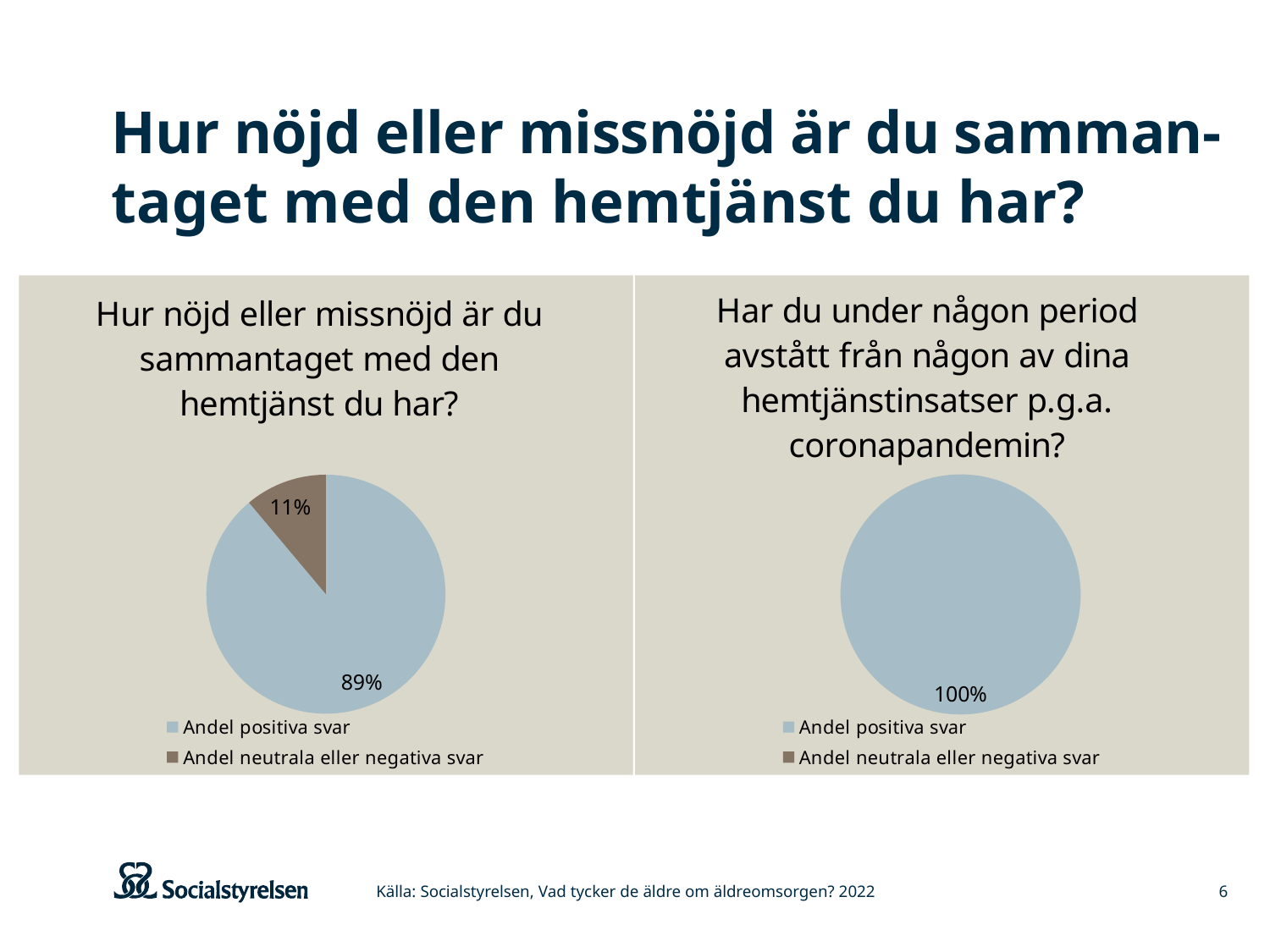
How many slices are visible in the right chart? 1 In the left chart, what is the difference in percentage points between 'Andel positiva svar' and 'Andel neutrala eller negativa svar'? 78 percentage points In the left chart, what share of answers is 'Andel positiva svar'? 89% How many charts are shown on the slide? 2 In the right chart, what share of answers is 'Andel positiva svar'? 100% In the left chart, which category has the smallest slice? Andel neutrala eller negativa svar In the left chart, which is larger: 'Andel positiva svar' or 'Andel neutrala eller negativa svar'? Andel positiva svar What type of chart is used on the left side of the slide? Pie chart What is the title of the right chart? Har du under någon period avstått från någon av dina hemtjänstinsatser p.g.a. coronapandemin? In the left chart, which category has the largest slice? Andel positiva svar How many entries does the legend of the right chart list? 2 In the left chart, what share of answers is 'Andel neutrala eller negativa svar'? 11%